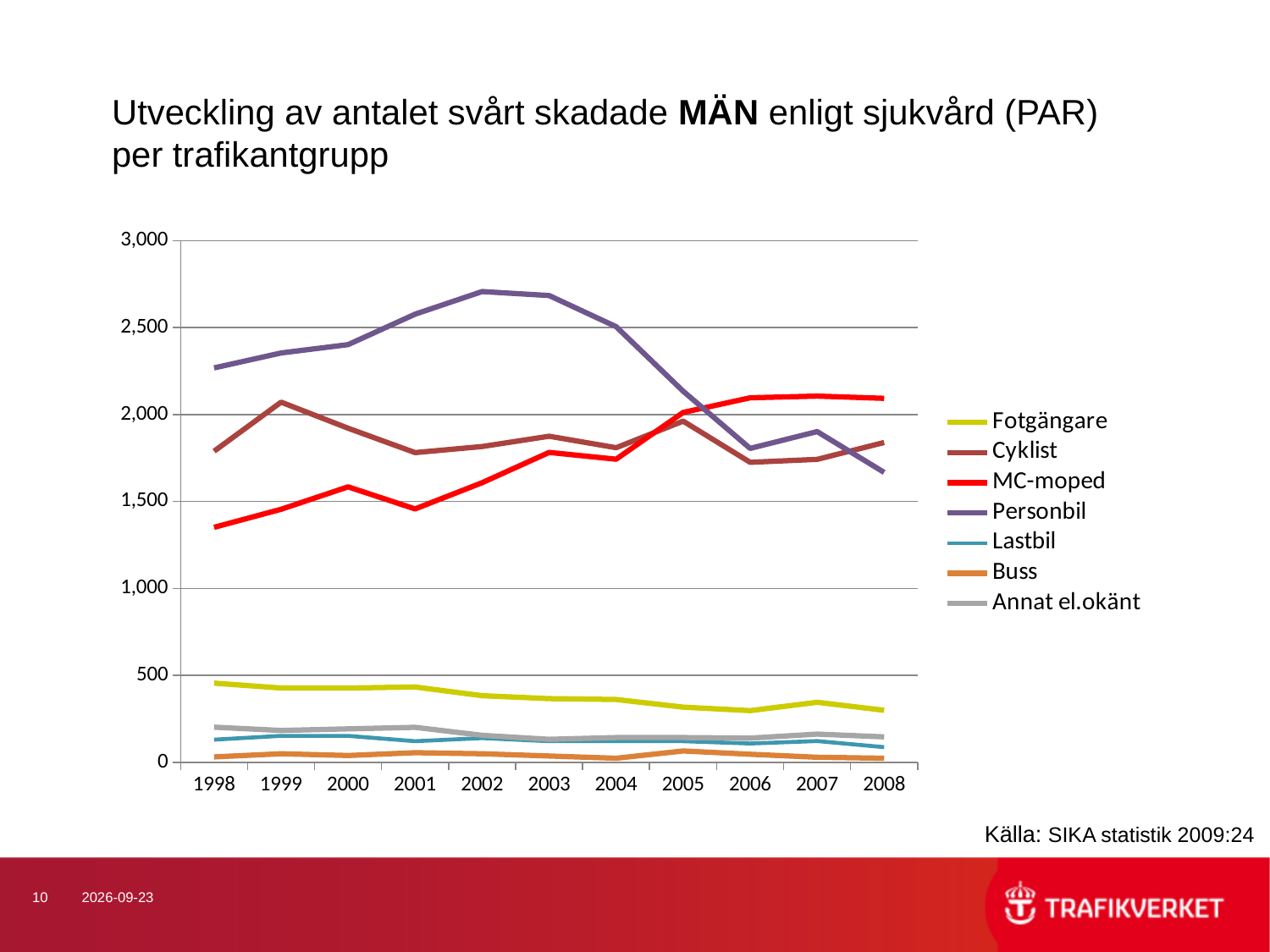
In 1999, which is larger: the value for Cyklist or the value for MC-moped? Cyklist How many years are shown on the x axis? 11 Which trafikantgrupp has the highest value in 1998? Personbil What colour is the MC-moped line? red How many series does the legend list? 7 Is the value for Personbil in 2002 greater or less than 2,500? greater What kind of chart is shown on the slide? line chart Which trafikantgrupp has the lowest values across the whole period? Buss Is the value for Fotgängare in 2008 greater or less than 500? less Is the value for MC-moped in 1998 greater or less than 1,500? less Does the Personbil line rise or fall from 2002 to 2008? fall Which trafikantgrupp has the highest value in 2008? MC-moped